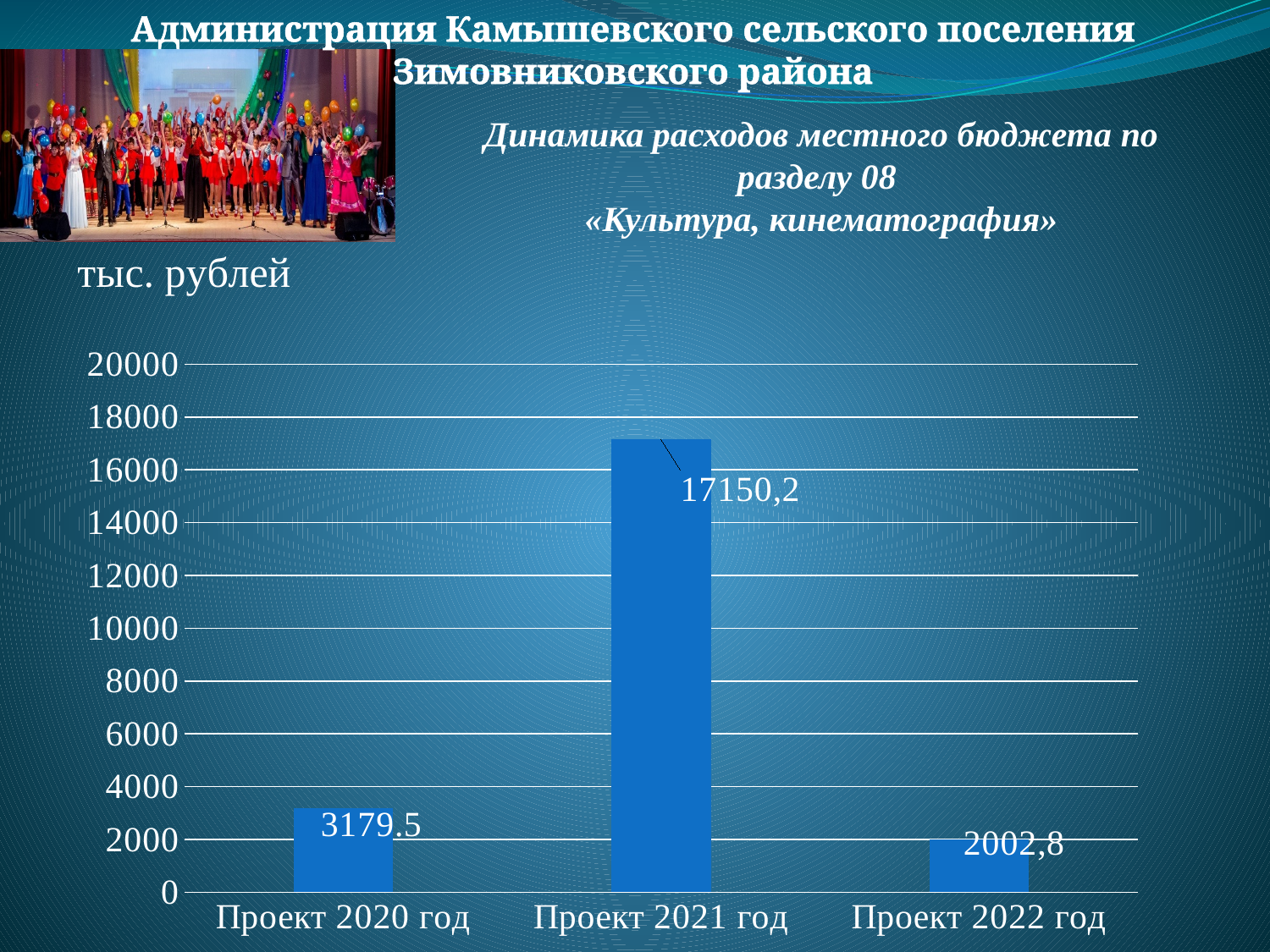
Is the value for Проект 2022 год greater or less than 4000? less What is the difference between the values for Проект 2021 год and Проект 2022 год? 15147,4 What kind of chart is shown on the slide? bar chart Is the value for Проект 2021 год greater or less than 16000? greater Which category has the highest value? Проект 2021 год What unit is stated above the chart? тыс. рублей What is the value for Проект 2020 год? 3179.5 How many categories are shown on the x axis? 3 Which is larger, the value for Проект 2020 год or Проект 2022 год? Проект 2020 год What is the value for Проект 2021 год? 17150,2 What is the value for Проект 2022 год? 2002,8 Which category has the lowest value? Проект 2022 год